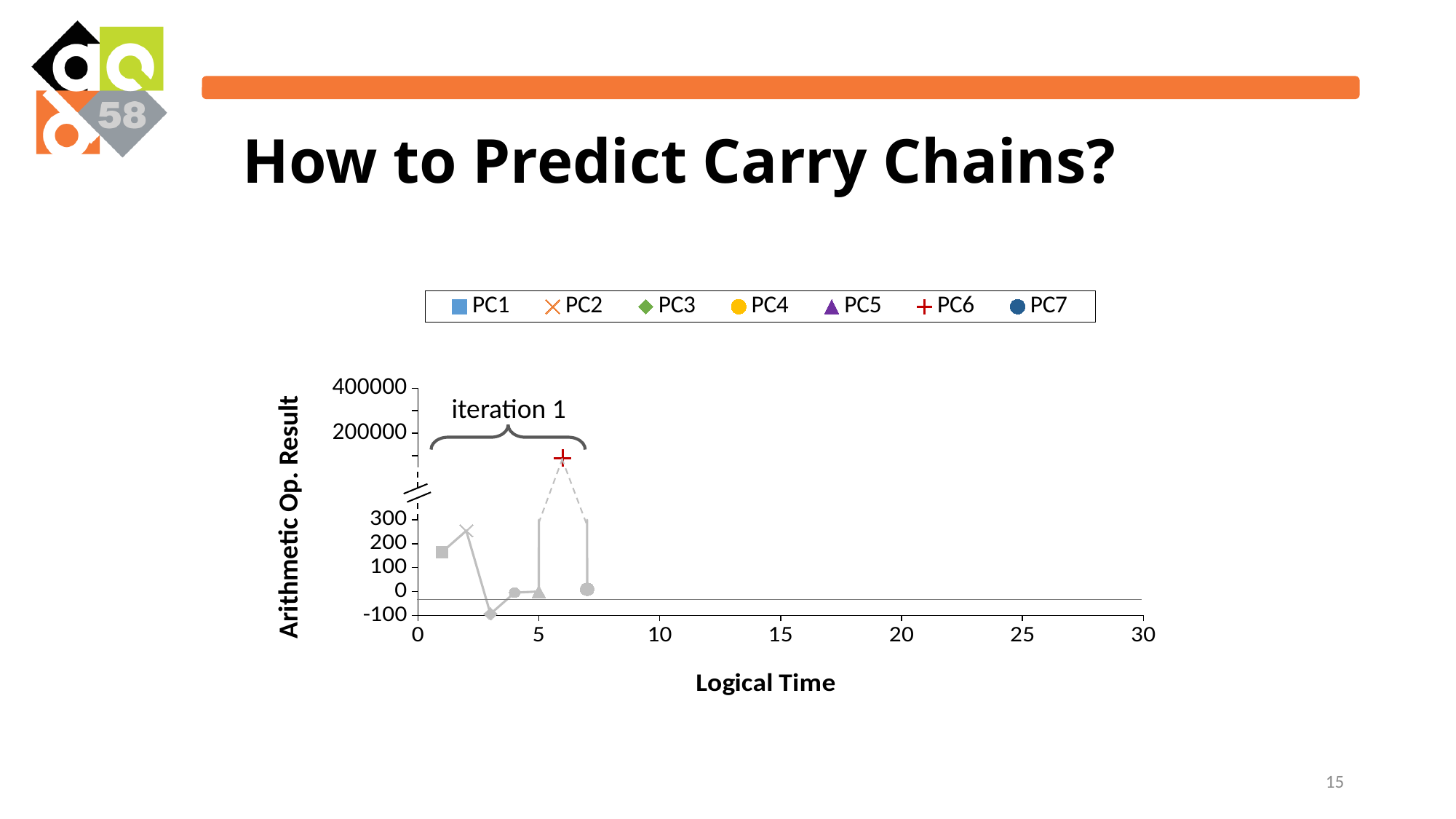
Which series has the highest Arithmetic Op. Result? PC6 Is the value for PC2 greater or less than 200? greater Which series has the lowest Arithmetic Op. Result? PC3 How many data points are plotted on the chart? 7 Which is larger, the value for PC1 or the value for PC3? PC1 Is the value for PC1 greater or less than 100? greater Is the value for PC6 greater or less than 300? greater What is the title of the x axis? Logical Time What label does the bracket annotation above the first points show? iteration 1 Which is larger, the value for PC1 or the value for PC2? PC2 How many series does the legend list? 7